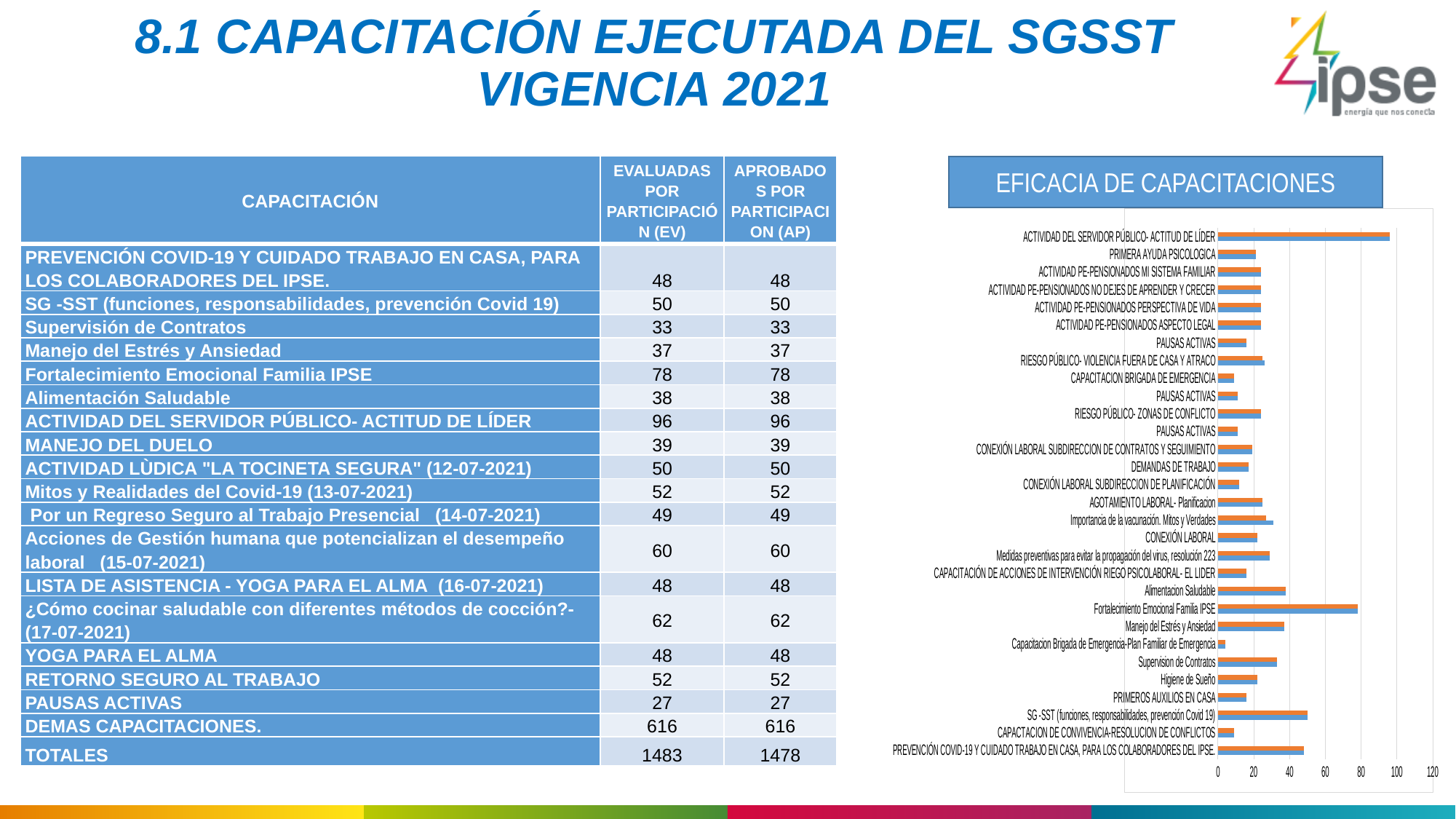
In the EFICACIA DE CAPACITACIONES chart, which is larger: ACTIVIDAD DEL SERVIDOR PÚBLICO- ACTITUD DE LÍDER or Alimentación Saludable? ACTIVIDAD DEL SERVIDOR PÚBLICO- ACTITUD DE LÍDER In the EFICACIA DE CAPACITACIONES chart, is the value for Supervisión de Contratos greater or less than 40? less In the EFICACIA DE CAPACITACIONES chart, is the value for PRIMEROS AUXILIOS EN CASA greater or less than 20? less In the EFICACIA DE CAPACITACIONES chart, which category has the longest bars? ACTIVIDAD DEL SERVIDOR PÚBLICO- ACTITUD DE LÍDER In the EFICACIA DE CAPACITACIONES chart, is the value for Fortalecimiento Emocional Familia IPSE greater or less than 60? greater What is the highest tick value shown on the horizontal axis of the EFICACIA DE CAPACITACIONES chart? 120 What is the title of the chart on the right side of the slide? EFICACIA DE CAPACITACIONES In the EFICACIA DE CAPACITACIONES chart, which category has the shortest bars? Capacitacion Brigada de Emergencia-Plan Familiar de Emergencia What kind of chart is shown under the title EFICACIA DE CAPACITACIONES? Bar chart How many categories are listed on the vertical axis of the EFICACIA DE CAPACITACIONES chart? 30 In the EFICACIA DE CAPACITACIONES chart, which is larger: Fortalecimiento Emocional Familia IPSE or Supervisión de Contratos? Fortalecimiento Emocional Familia IPSE